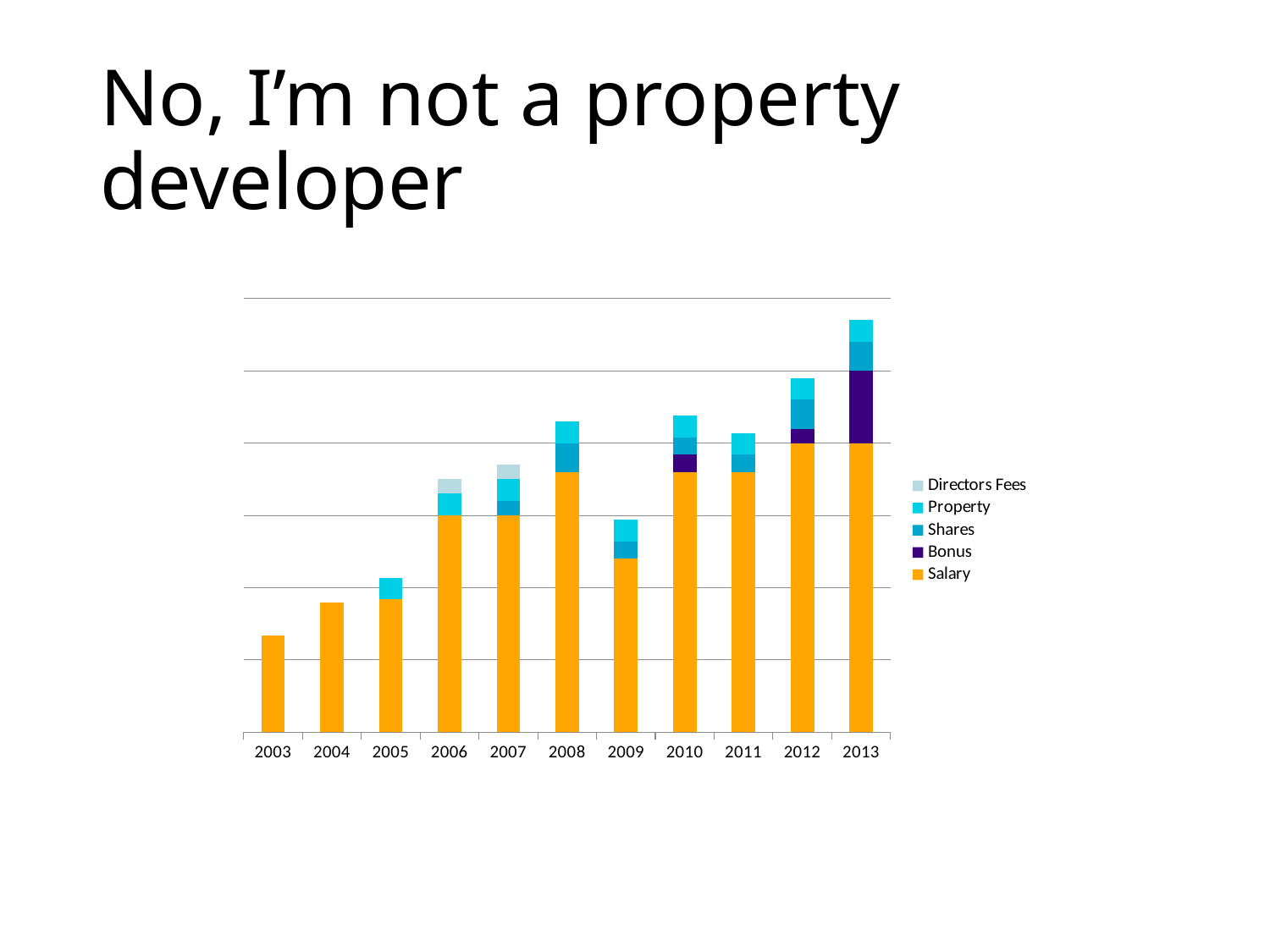
Which year has the shortest stacked bar? 2003 Which series is shown in orange in the chart? Salary Which series appears at the bottom of each stacked bar? Salary Which year has the largest Bonus segment? 2013 What kind of chart is shown on the slide? Stacked bar chart How many series does the chart's legend list? 5 How many years are shown along the x axis of the chart? 11 Do the stacked bar totals generally rise or fall from 2003 to 2013? Rise Which year has the tallest stacked bar? 2013 Which year has the taller stacked bar, 2008 or 2009? 2008 In which years does the Directors Fees segment appear? 2006 and 2007 Which year has the taller stacked bar, 2012 or 2011? 2012